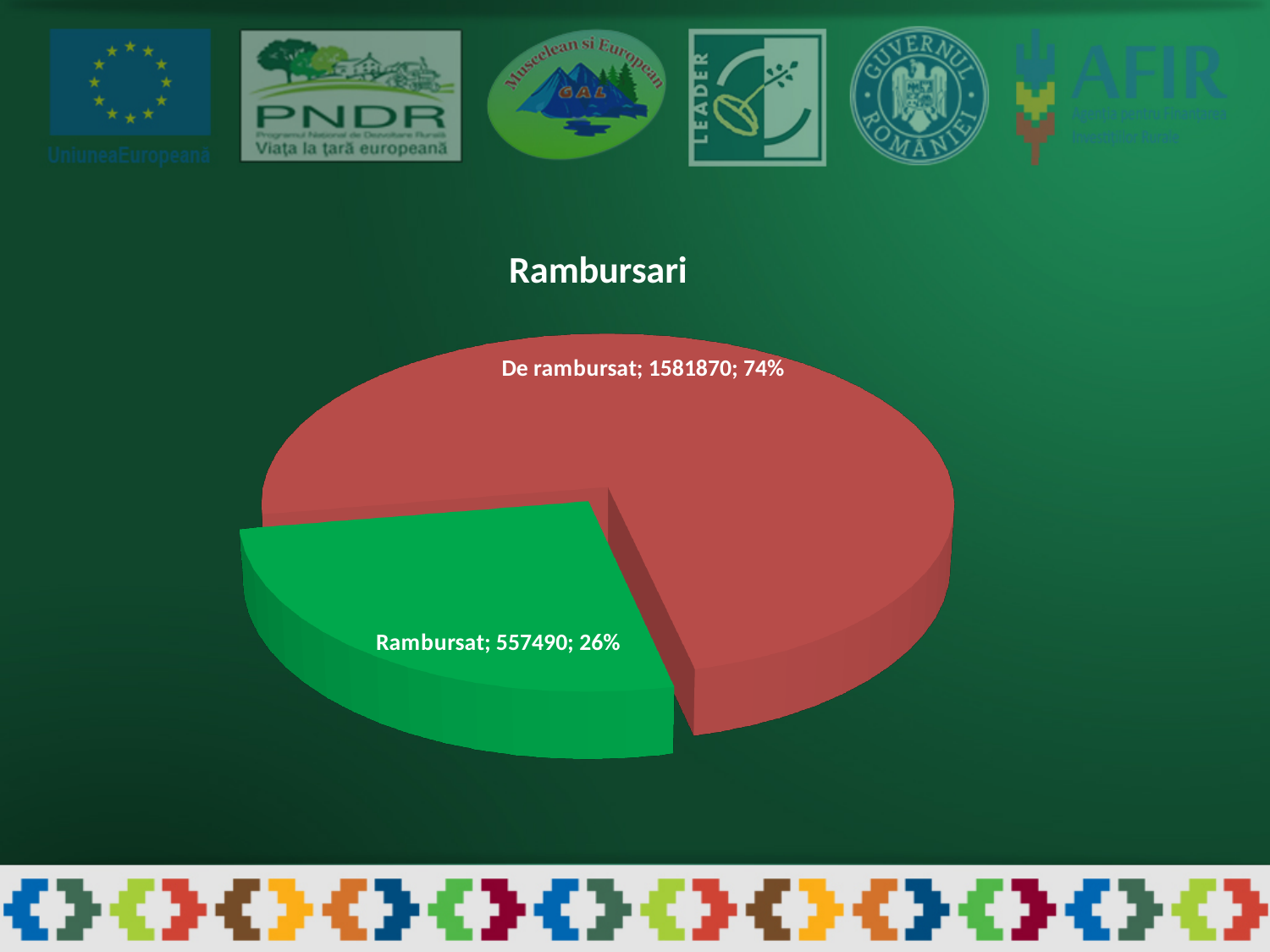
How many slices does the pie chart have? 2 What is the difference between the values for De rambursat and Rambursat? 1024380 What is the value for Rambursat? 557490 What share of the pie does De rambursat represent? 74% Which slice is the largest? De rambursat Which slice is the smallest? Rambursat What is the title of the chart? Rambursari Which is larger, Rambursat or De rambursat? De rambursat What kind of chart is shown on the slide? Pie chart What is the value for De rambursat? 1581870 What share of the pie does Rambursat represent? 26% What colour is the Rambursat slice? Green